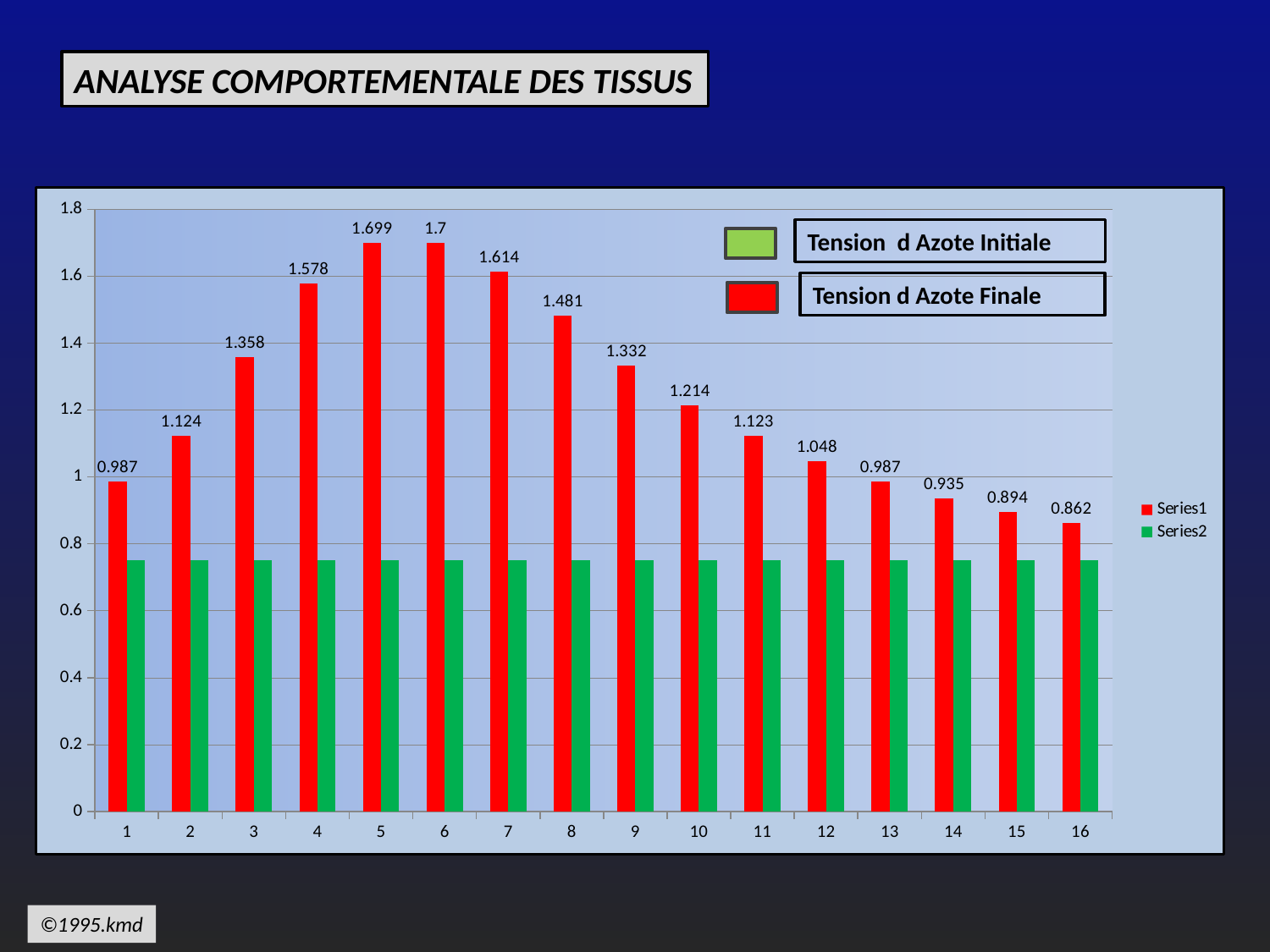
How many series does the legend list? 2 Which is larger, the Series1 value for category 4 or for category 9? category 4 What is the difference between the Series1 values for category 8 and category 9? 0.149 What is the Series1 value for category 16? 0.862 Which category has the lowest Series1 value? 16 Do the Series1 values rise or fall from category 6 to category 16? fall What is the Series1 value for category 12? 1.048 What is the difference between the Series1 values for category 5 and category 1? 0.712 What is the Series1 value for category 5? 1.699 How many categories are shown on the x axis? 16 Is the Series2 value for category 1 greater or less than 0.8? less What kind of chart is shown on the slide? bar chart